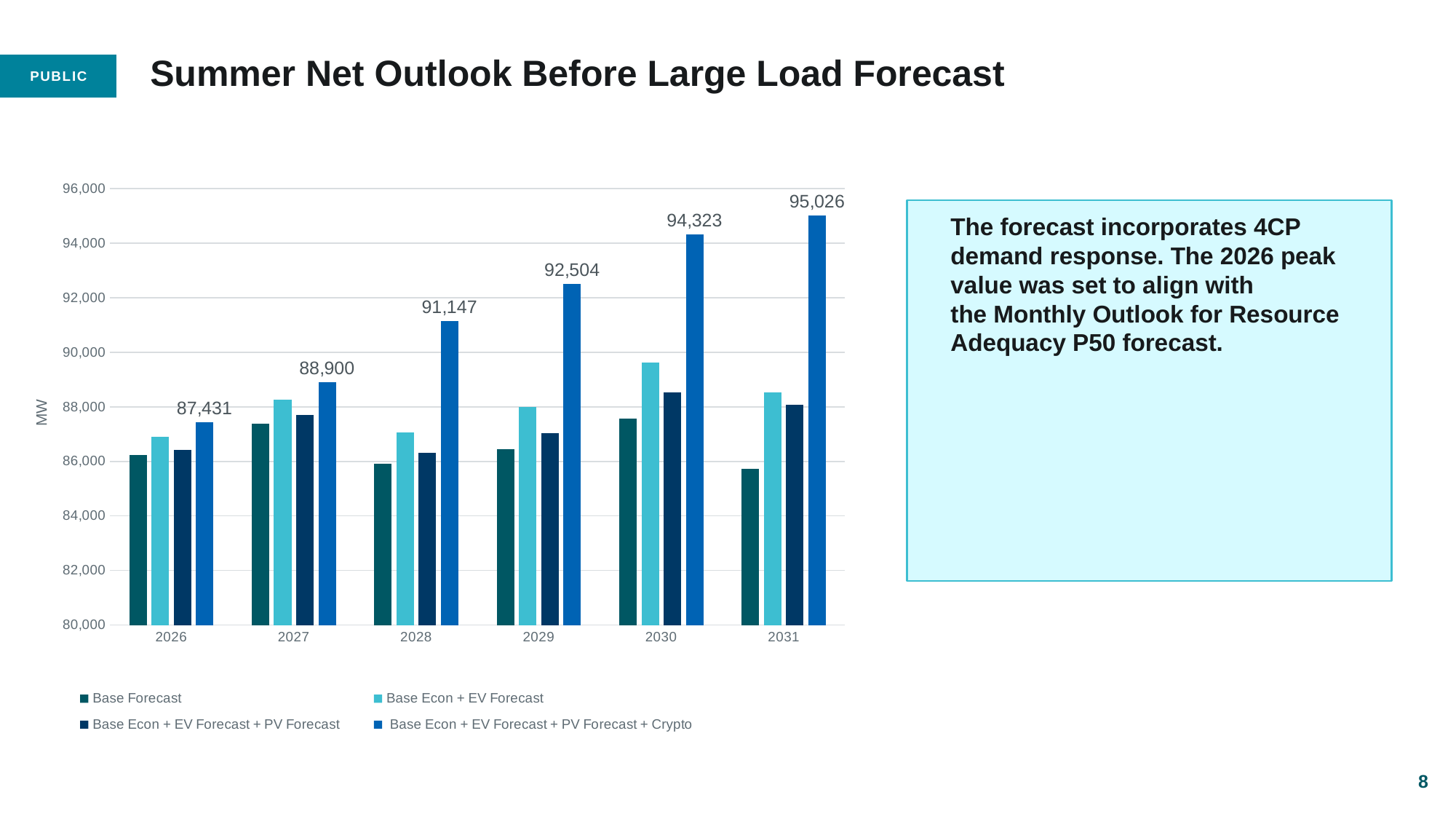
In which year is the Base Econ + EV Forecast + PV Forecast + Crypto value lowest? 2026 Is the Base Econ + EV Forecast value for 2030 greater or less than 88,000? greater Is the Base Forecast value for 2031 greater or less than 86,000? less How many series does the legend list? 4 What is the difference between the Base Econ + EV Forecast + PV Forecast + Crypto values for 2030 and 2028? 3,176 How many years are shown on the x axis? 6 What is the value of the Base Econ + EV Forecast + PV Forecast + Crypto series for 2029? 92,504 In which year is the Base Econ + EV Forecast + PV Forecast + Crypto value highest? 2031 Which is larger: the Base Econ + EV Forecast + PV Forecast + Crypto value for 2027 or for 2028? 2028 What is the value of the Base Econ + EV Forecast + PV Forecast + Crypto series for 2026? 87,431 What kind of chart is shown on the slide? Bar chart What is the value of the Base Econ + EV Forecast + PV Forecast + Crypto series for 2031? 95,026